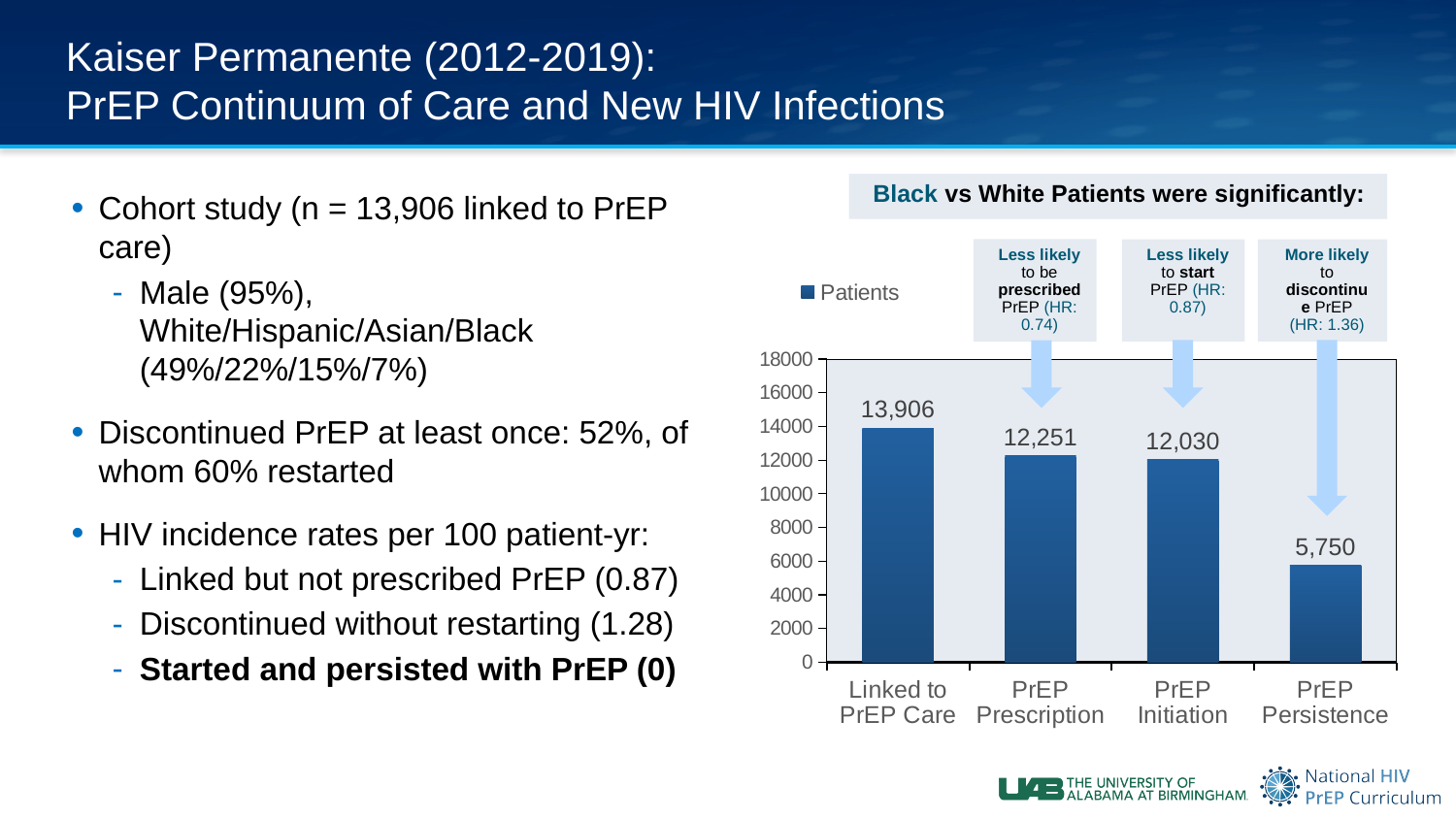
What is the number of patients for PrEP Initiation? 12,030 How many categories are shown on the x axis of the chart? 4 What is the difference in patients between PrEP Initiation and PrEP Persistence? 6,280 Do the values rise or fall from Linked to PrEP Care to PrEP Persistence? Fall What is the difference in patients between Linked to PrEP Care and PrEP Prescription? 1,655 Which has more patients, PrEP Prescription or PrEP Persistence? PrEP Prescription What is the number of patients for PrEP Prescription? 12,251 What is the number of patients for PrEP Persistence? 5,750 Which category has the highest number of patients? Linked to PrEP Care What kind of chart is shown on the slide? Bar chart What is the number of patients for Linked to PrEP Care? 13,906 Which category has the lowest number of patients? PrEP Persistence